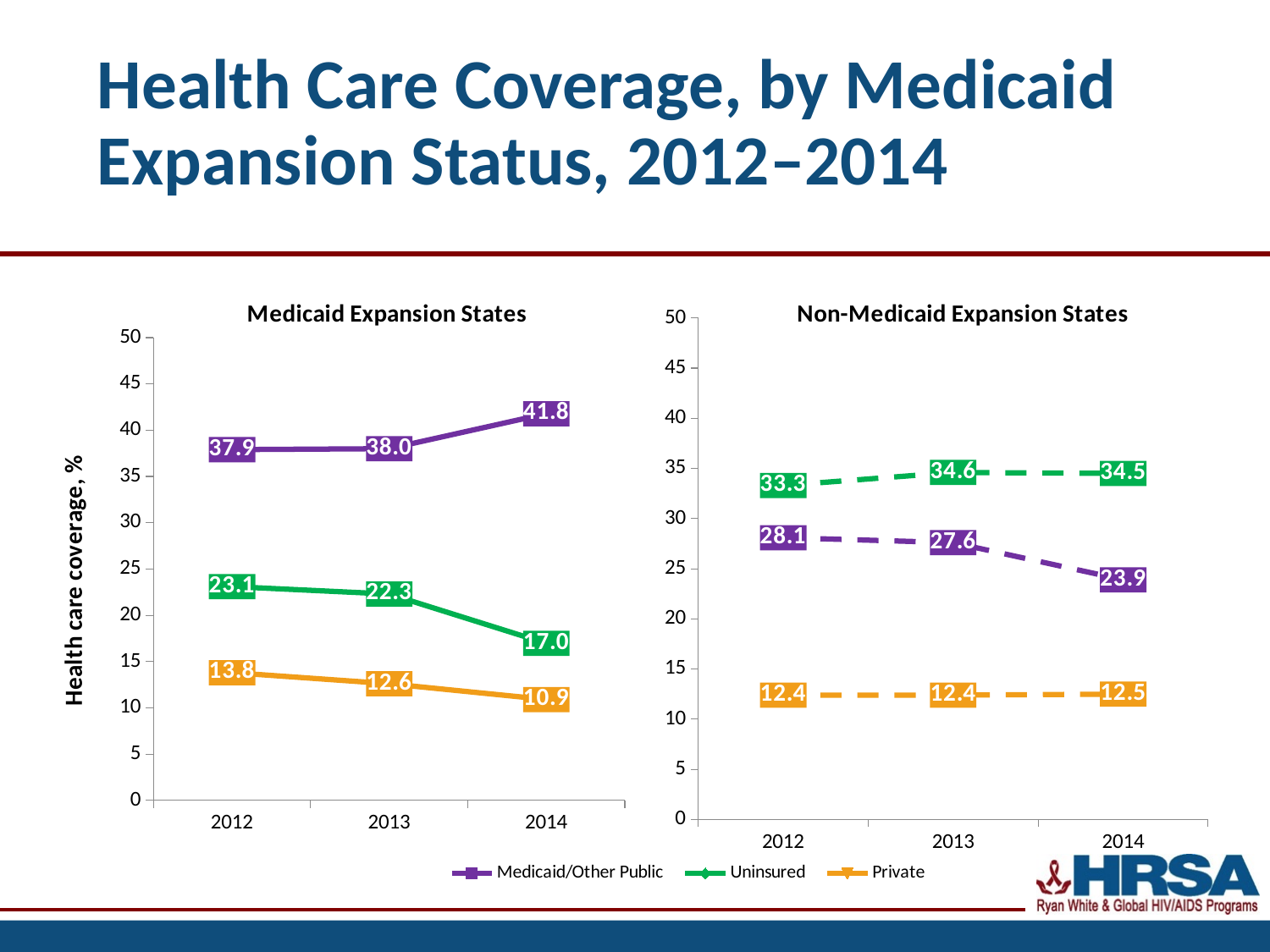
In the Medicaid Expansion States chart, what is the Medicaid/Other Public coverage value for 2014? 41.8 In the Medicaid Expansion States chart, what is the difference between the Uninsured values for 2012 and 2014? 6.1 In the Non-Medicaid Expansion States chart, what is the Uninsured value for 2013? 34.6 In the Medicaid Expansion States chart, does the Medicaid/Other Public series rise or fall from 2012 to 2014? rise In the Non-Medicaid Expansion States chart, what is the Medicaid/Other Public value for 2014? 23.9 How many series does the legend list? 3 In the Non-Medicaid Expansion States chart, what is the difference between the Medicaid/Other Public values for 2012 and 2014? 4.2 In the Medicaid Expansion States chart, in which year is the Uninsured value lowest? 2014 In the Medicaid Expansion States chart, what is the Private coverage value for 2012? 13.8 What kind of chart is the Non-Medicaid Expansion States chart? line chart In the Non-Medicaid Expansion States chart, in which year is the Medicaid/Other Public value highest? 2012 Which is larger: the 2014 Uninsured value in the Medicaid Expansion States chart or the 2014 Uninsured value in the Non-Medicaid Expansion States chart? Non-Medicaid Expansion States